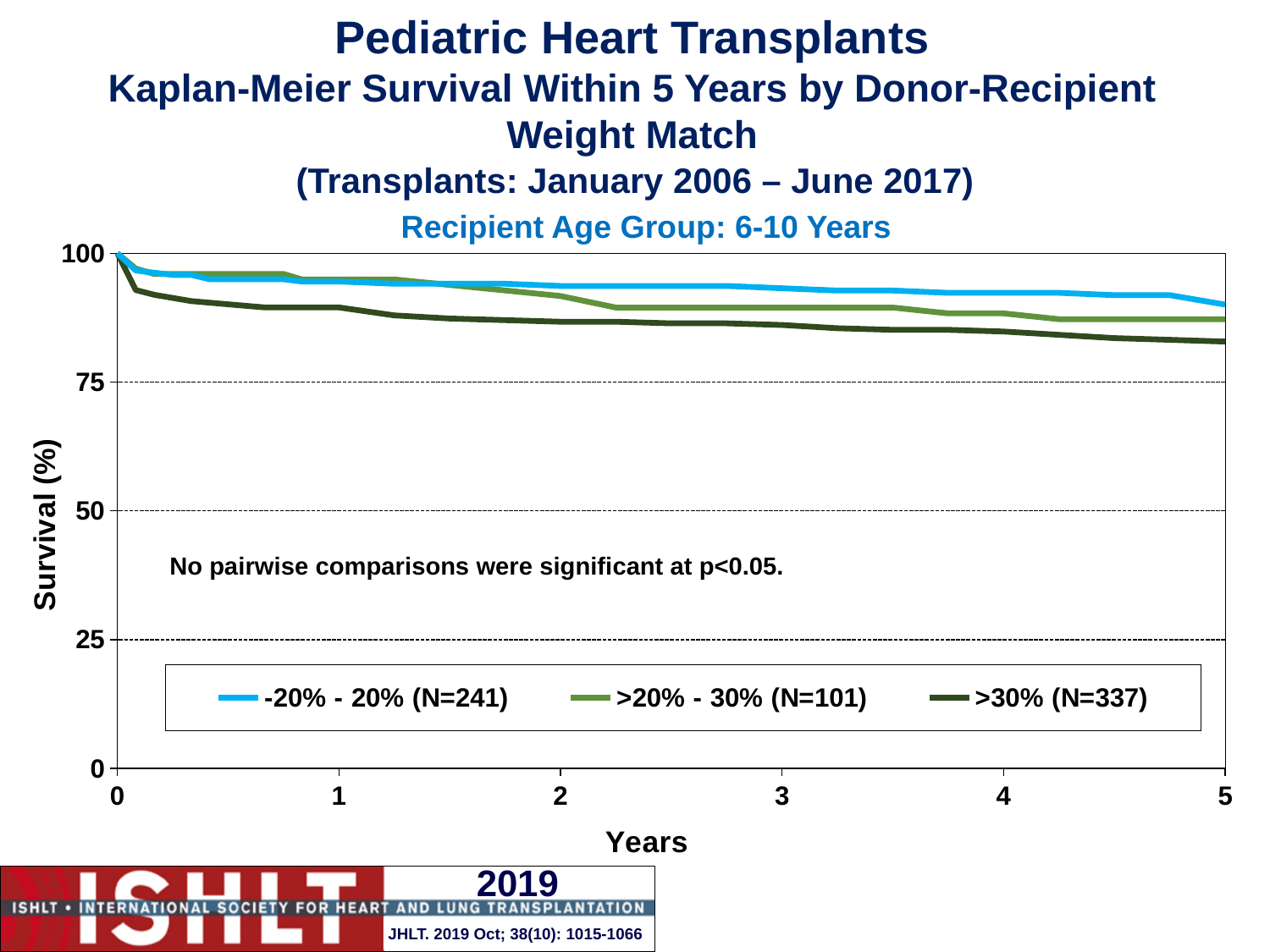
Is the survival value for the >30% group at 5 years greater or less than 75? greater Which weight-match group has the highest survival at 5 years? -20% - 20% (N=241) What is the N for the >20% - 30% group shown in the legend? N=101 Which weight-match group has the lowest survival at 5 years? >30% (N=337) How many series does the legend list? 3 At 5 years, is survival higher for the -20% - 20% group or the >30% group? -20% - 20% Is the survival value for the -20% - 20% group at 4 years greater or less than 75? greater At 3 years, is survival higher for the >20% - 30% group or the >30% group? >20% - 30% Do the survival curves rise or fall as years increase? Fall What kind of chart is shown on the slide? Line chart What is the label of the y axis? Survival (%)